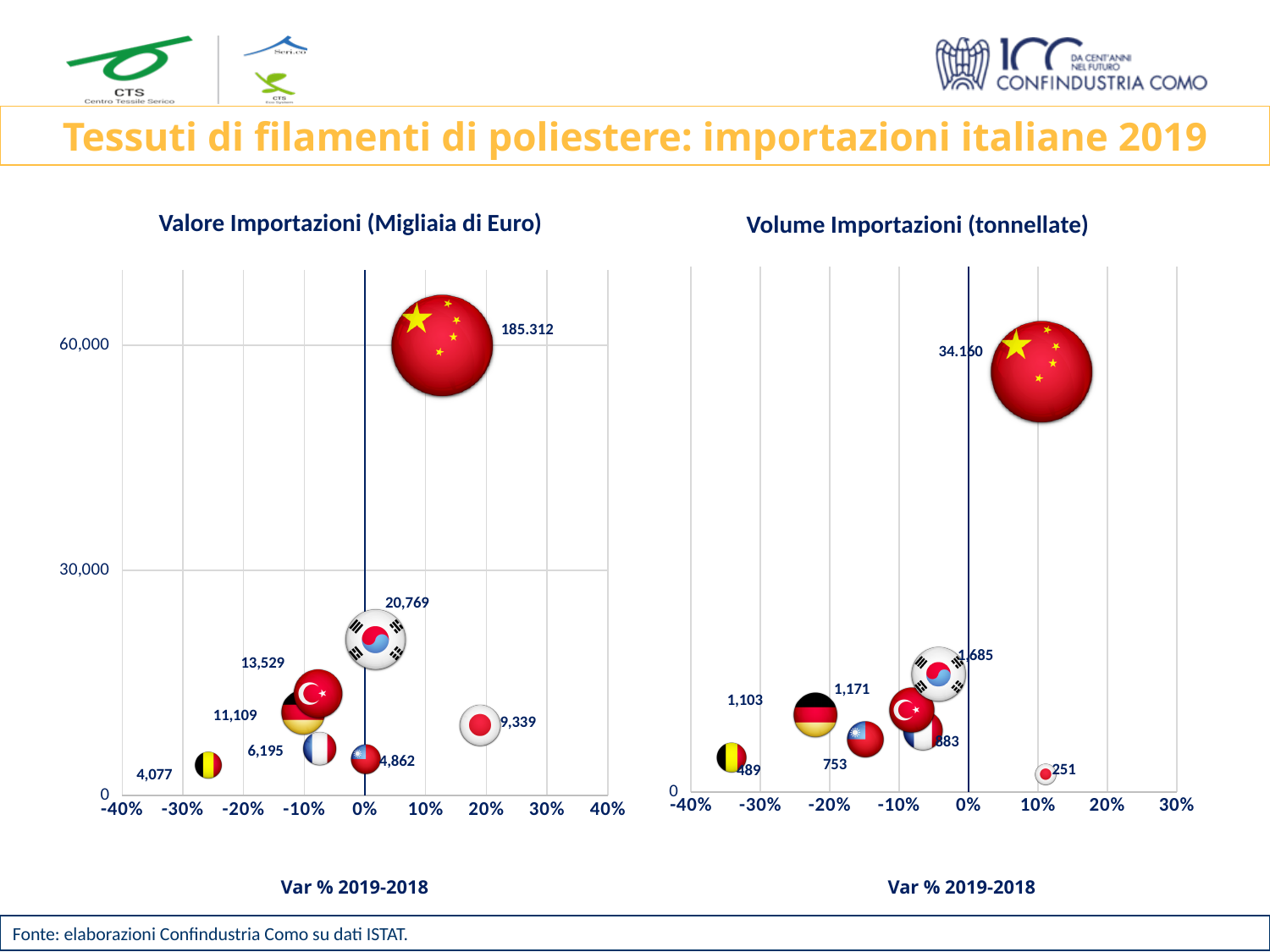
In the 'Valore Importazioni (Migliaia di Euro)' chart, is the bubble with the Japanese flag (9,339) plotted at a positive or negative Var % 2019-2018? positive In the 'Valore Importazioni (Migliaia di Euro)' chart, what is the smallest labelled value? 4,077 What kind of chart is the 'Valore Importazioni (Migliaia di Euro)' chart? bubble chart In the 'Valore Importazioni (Migliaia di Euro)' chart, what is the difference between the values labelled 20,769 and 9,339? 11,430 In the 'Volume Importazioni (tonnellate)' chart, what is the smallest labelled value? 251 How many bubbles are plotted in the 'Volume Importazioni (tonnellate)' chart? 8 In the 'Valore Importazioni (Migliaia di Euro)' chart, which is larger: the value labelled 13,529 (Turkish flag) or the value labelled 11,109 (German flag)? 13,529 In the 'Volume Importazioni (tonnellate)' chart, what value is labelled on the largest bubble (the one with the Chinese flag)? 34.160 In the 'Volume Importazioni (tonnellate)' chart, what value is labelled on the bubble with the Turkish flag? 1,171 In the 'Valore Importazioni (Migliaia di Euro)' chart, what value is labelled on the largest bubble (the one with the Chinese flag)? 185.312 What is the x-axis label of both charts on the slide? Var % 2019-2018 In the 'Valore Importazioni (Migliaia di Euro)' chart, what value is labelled on the bubble with the South Korean flag? 20,769